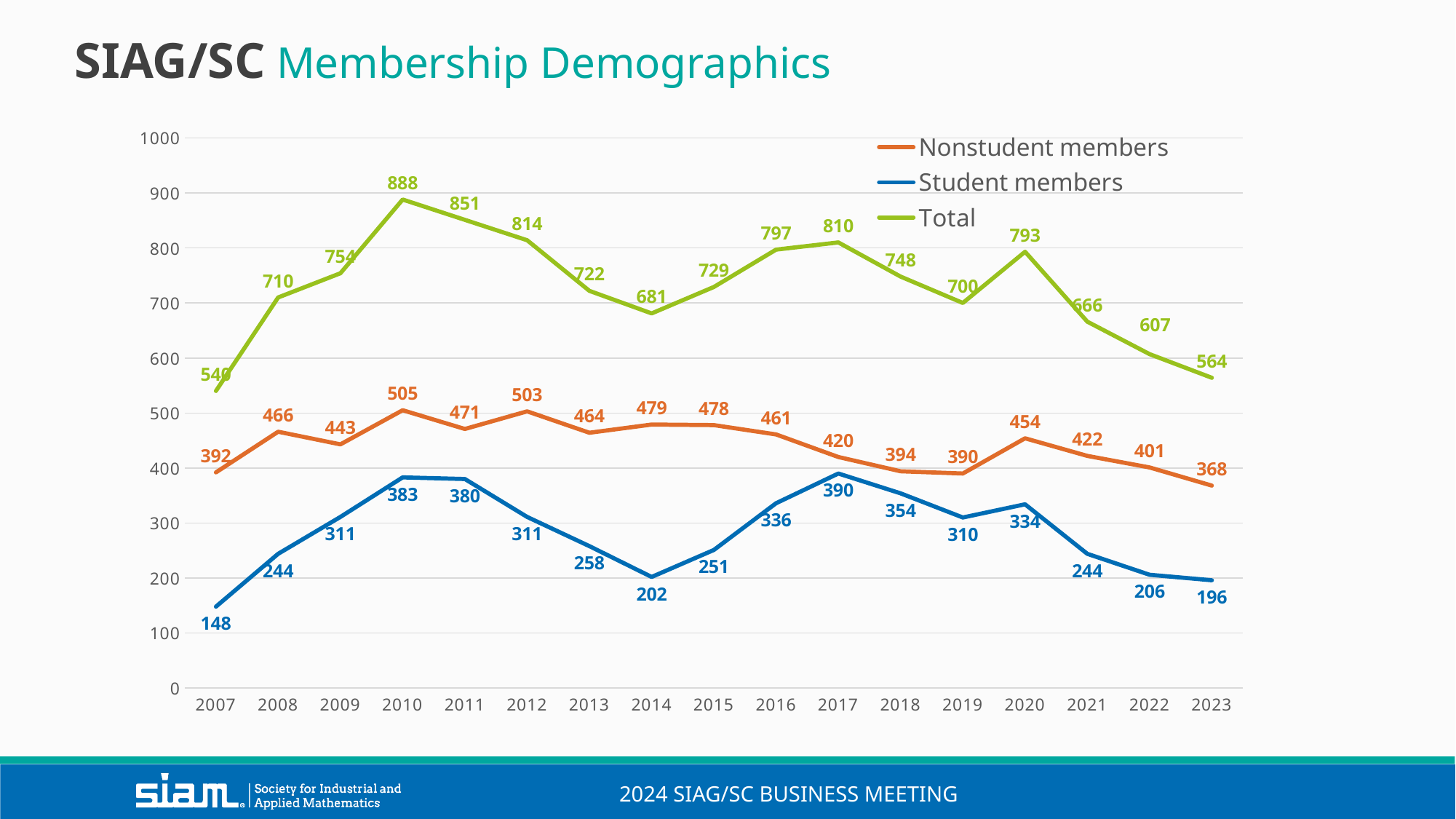
Did the Total membership rise or fall from 2020 to 2023? Fall What is the difference between Nonstudent members in 2010 and in 2023? 137 Which was larger in 2017: Student members or Nonstudent members? Nonstudent members What was the Total membership in 2010? 888 What colour is the line for Student members? Blue How many years are shown on the x axis? 17 In which year was the number of Student members lowest? 2007 How many Student members were there in 2014? 202 How many series does the legend list? 3 In which year was the Total membership highest? 2010 How many Nonstudent members were there in 2023? 368 What kind of chart is shown on the slide? Line chart